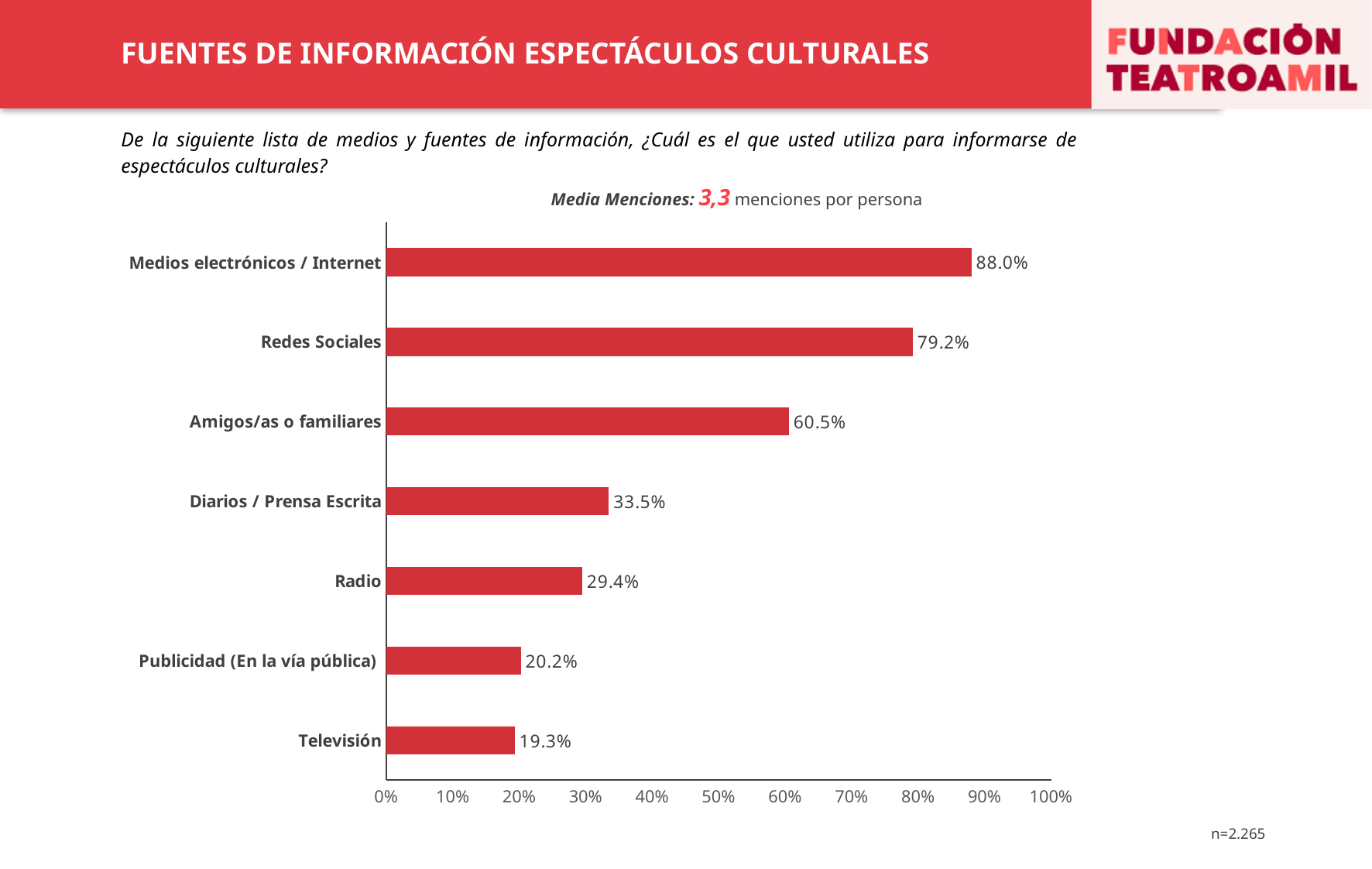
Which category has the lowest value? Televisión Which is larger, the value for Diarios / Prensa Escrita or the value for Radio? Diarios / Prensa Escrita Which category has the highest value? Medios electrónicos / Internet What is the value for Radio? 29.4% What is the average number of mentions per person stated above the chart? 3,3 What is the difference between the values for Medios electrónicos / Internet and Redes Sociales? 8.8% What kind of chart is shown on the slide? Bar chart What is the value for Amigos/as o familiares? 60.5% Is the value for Amigos/as o familiares greater or less than 50%? greater How many categories are shown in the chart? 7 What is the value for Redes Sociales? 79.2% What is the value for Medios electrónicos / Internet? 88.0%